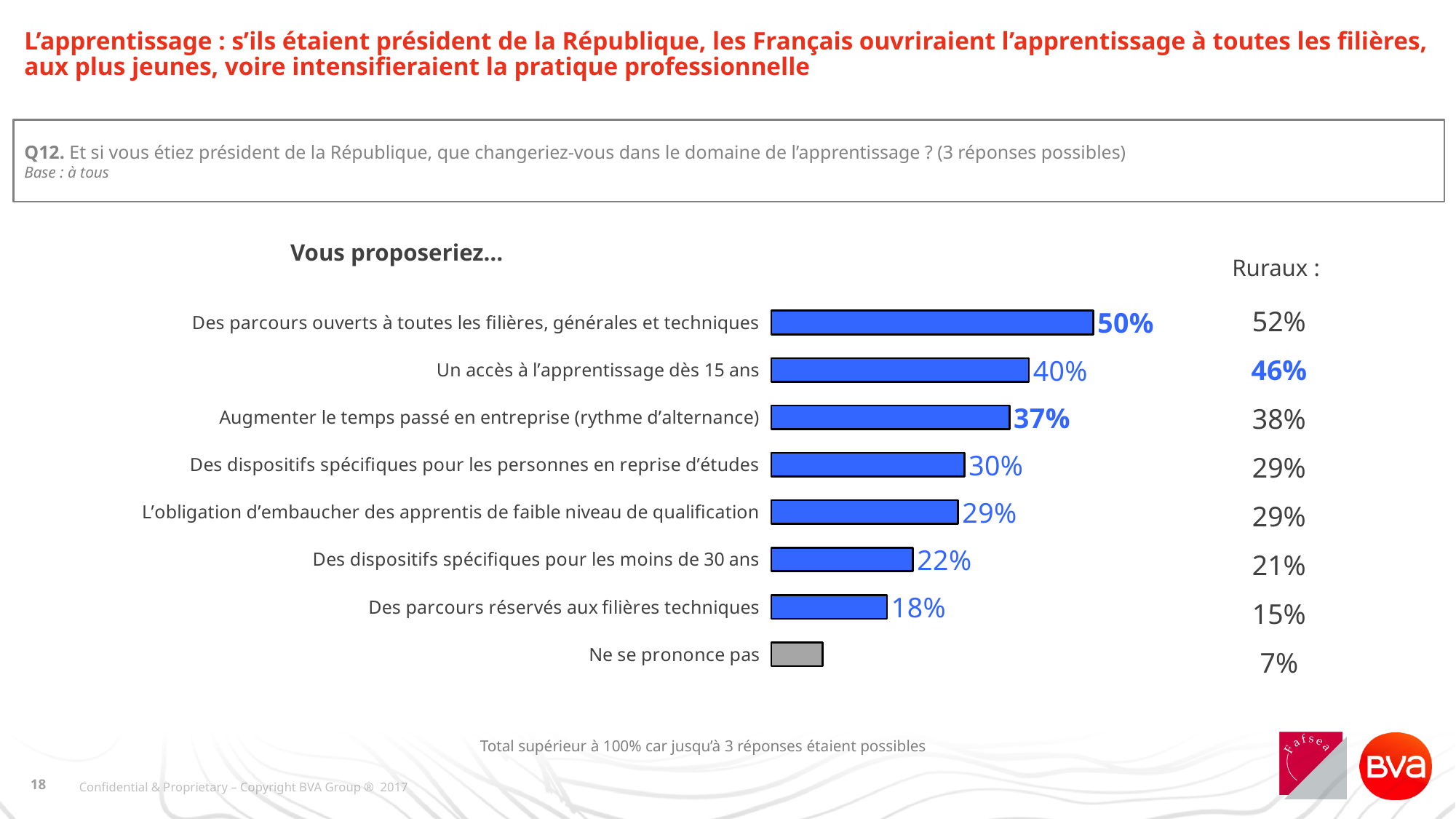
What is the difference between the values for "Un accès à l'apprentissage dès 15 ans" and "Augmenter le temps passé en entreprise (rythme d'alternance)"? 3% What type of chart is shown on the slide? bar chart What is the "Ruraux" value shown next to "Un accès à l'apprentissage dès 15 ans"? 46% What is the value for "Des parcours ouverts à toutes les filières, générales et techniques"? 50% What is the value for "Un accès à l'apprentissage dès 15 ans"? 40% What is the value for "Des dispositifs spécifiques pour les moins de 30 ans"? 22% What colour is the bar for "Ne se prononce pas"? grey Which category has the highest value in the chart? Des parcours ouverts à toutes les filières, générales et techniques What is the value for "Des parcours réservés aux filières techniques"? 18% Which is larger: the value for "Des dispositifs spécifiques pour les personnes en reprise d'études" or for "Des dispositifs spécifiques pour les moins de 30 ans"? Des dispositifs spécifiques pour les personnes en reprise d'études How many categories are shown in the bar chart? 8 Which labelled category has the lowest value in the chart? Des parcours réservés aux filières techniques